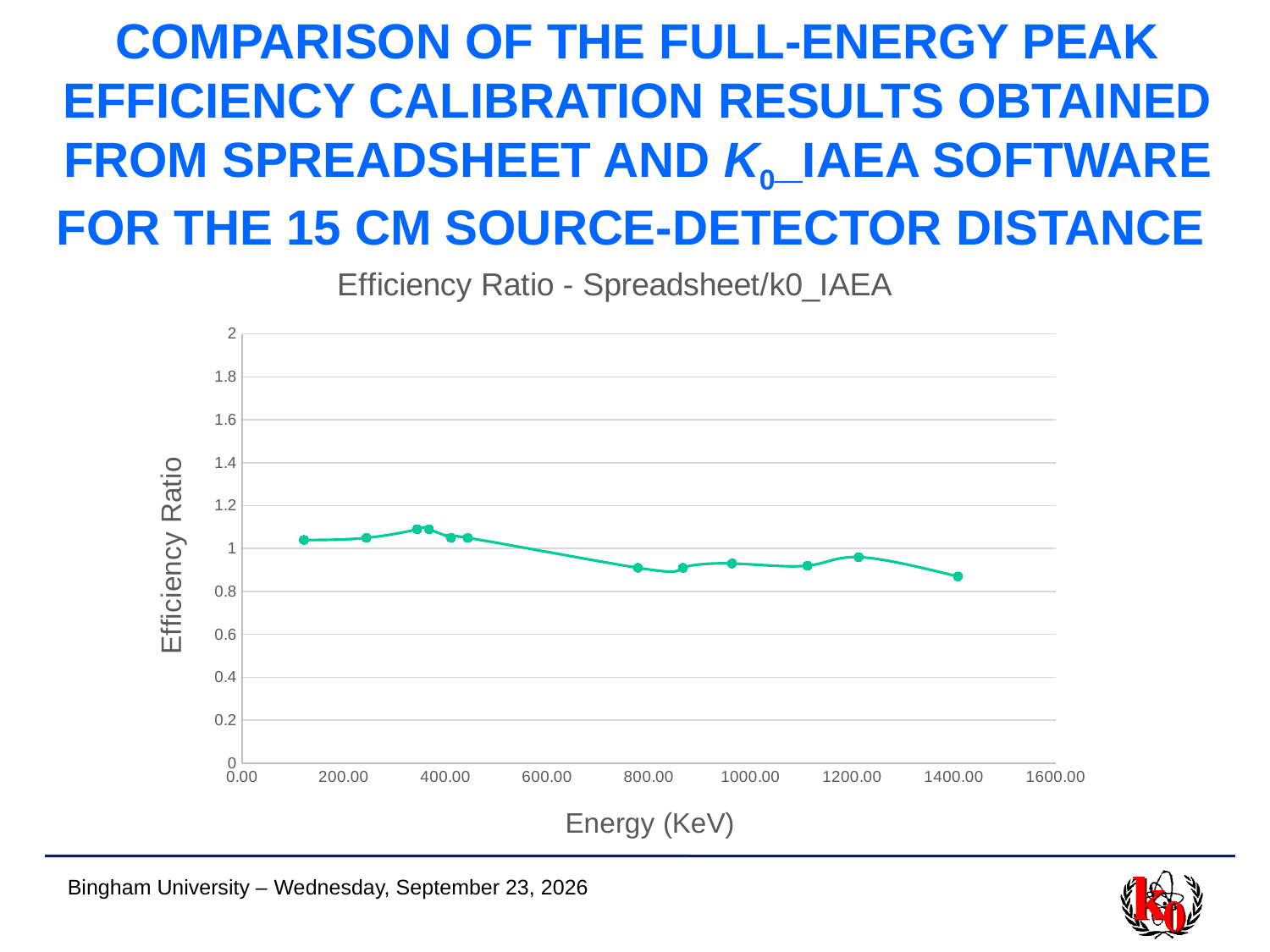
Are all plotted efficiency ratio values greater or less than 0.6? greater How many data points are plotted on the chart? 12 What is the label of the x axis of the chart? Energy (KeV) Is the efficiency ratio at around 350 keV greater or less than 1.2? less What kind of chart is shown on the slide? line chart What is the title of the chart? Efficiency Ratio - Spreadsheet/k0_IAEA Is the efficiency ratio at the lowest plotted energy (around 120 keV) greater or less than 1? greater What is the highest value shown on the y axis of the chart? 2 Which is larger: the efficiency ratio at around 350 keV or at around 1400 keV? around 350 keV Overall, does the efficiency ratio rise or fall as energy increases from left to right? fall